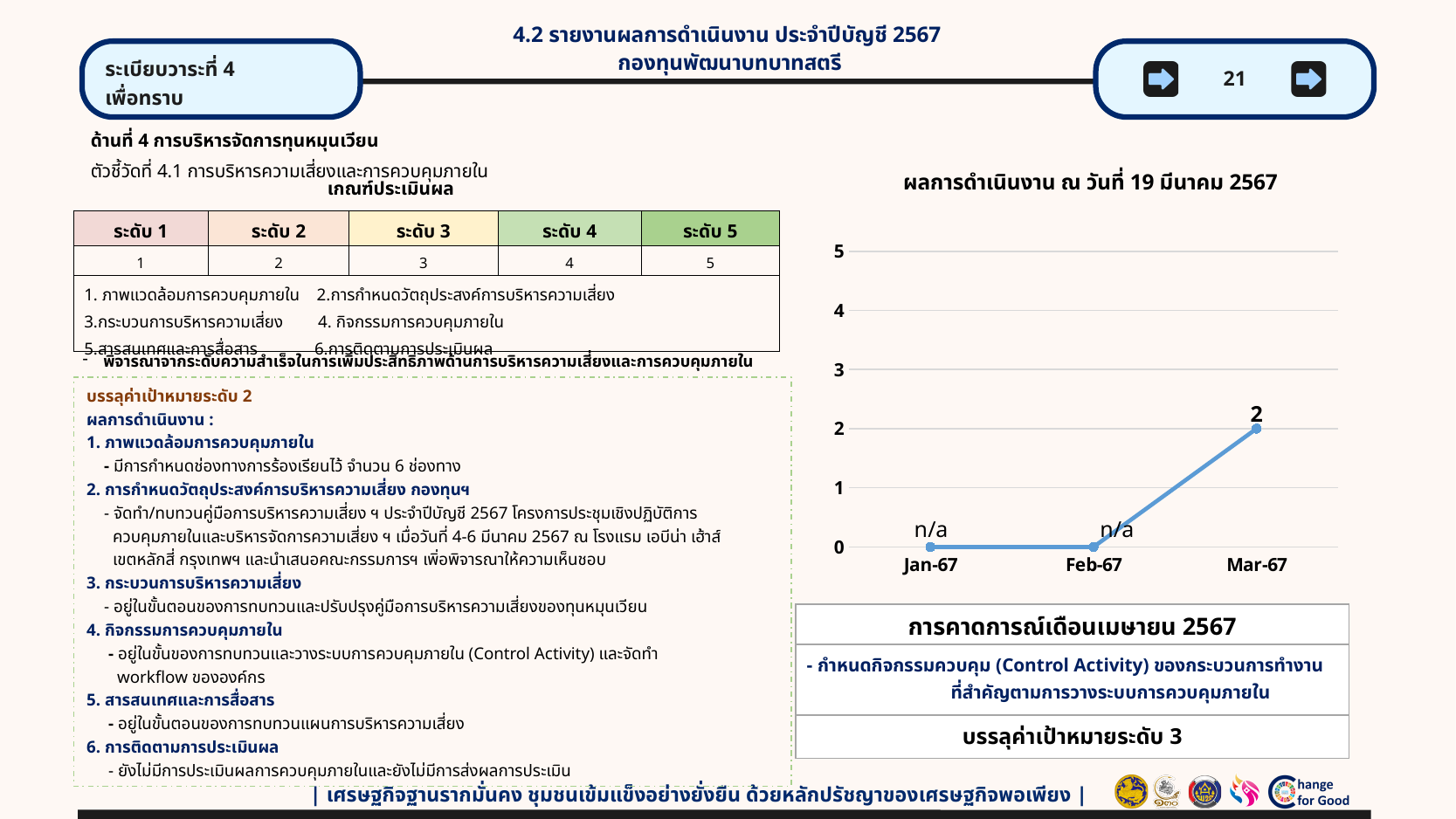
What data label is shown for Feb-67? n/a Is the value for Mar-67 greater or less than 1? greater Does the line rise or fall between Feb-67 and Mar-67? rise What data label is shown for Jan-67? n/a Which is larger, the plotted value for Mar-67 or Jan-67? Mar-67 What type of chart is shown on the slide? line chart What is the title of the chart? ผลการดำเนินงาน ณ วันที่ 19 มีนาคม 2567 What is the maximum value shown on the vertical axis? 5 Is the value for Mar-67 greater or less than 3? less How many points are plotted on the line chart? 3 Which month has the highest plotted value? Mar-67 What is the value plotted for Mar-67? 2